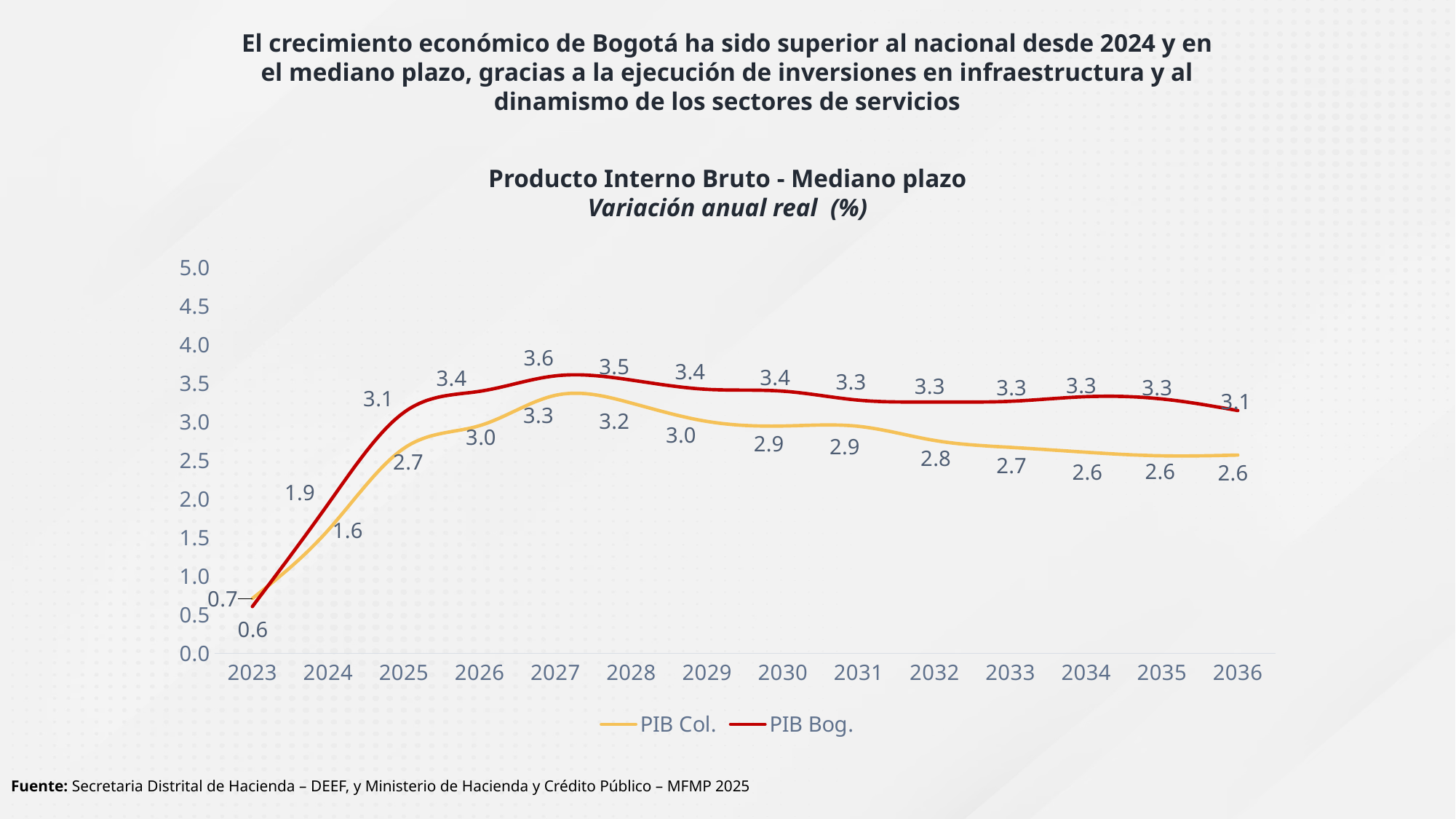
What is the value of PIB Bog. in 2024? 1.9 Which series has the higher value in 2030, PIB Col. or PIB Bog.? PIB Bog. In which year does PIB Bog. reach its highest value? 2027 How many series does the legend list? 2 What is the difference between PIB Bog. and PIB Col. in 2033? 0.6 What is the value of PIB Bog. in 2027? 3.6 How many years are plotted along the x axis? 14 What type of chart is shown on the slide? Line chart What is the subtitle shown in italics under the chart title 'Producto Interno Bruto - Mediano plazo'? Variación anual real (%) What is the value of PIB Col. in 2025? 2.7 What is the value of PIB Col. in 2036? 2.6 In which year is PIB Col. at its lowest value? 2023